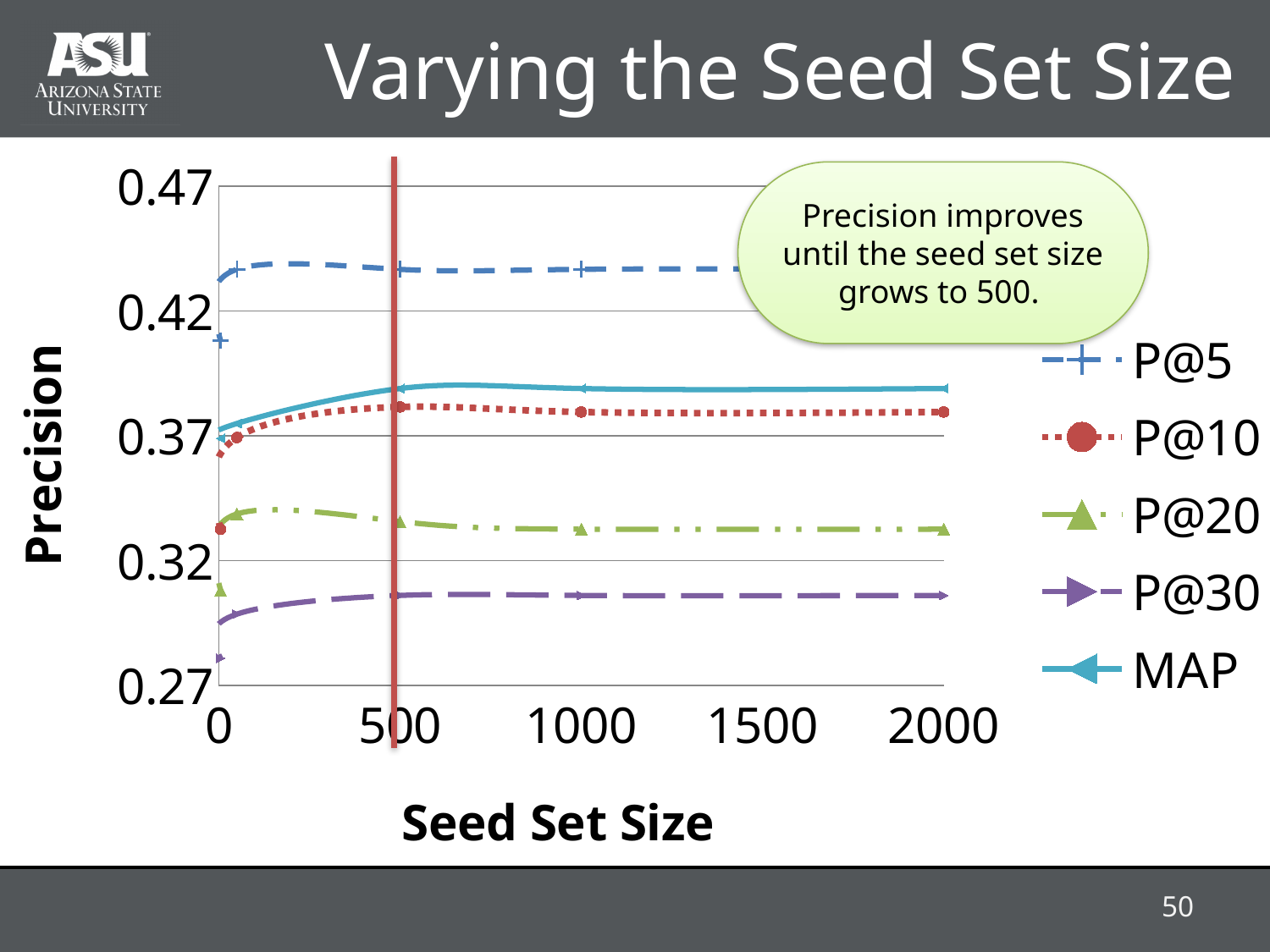
Which series has the lowest precision across all seed set sizes? P@30 What is the label of the y axis? Precision What kind of chart is shown on the slide? line chart Which series has the highest precision across all seed set sizes? P@5 How many series does the legend list? 5 At a seed set size of 1000, which is larger: P@10 or P@20? P@10 Is the P@5 value at a seed set size of 1000 greater or less than 0.42? greater Does the P@5 line rise or fall as the seed set size increases from 0 to 500? rise What is the label of the x axis? Seed Set Size Is the P@10 value at a seed set size of 500 greater or less than 0.37? greater Is the P@20 value at a seed set size of 2000 greater or less than 0.37? less